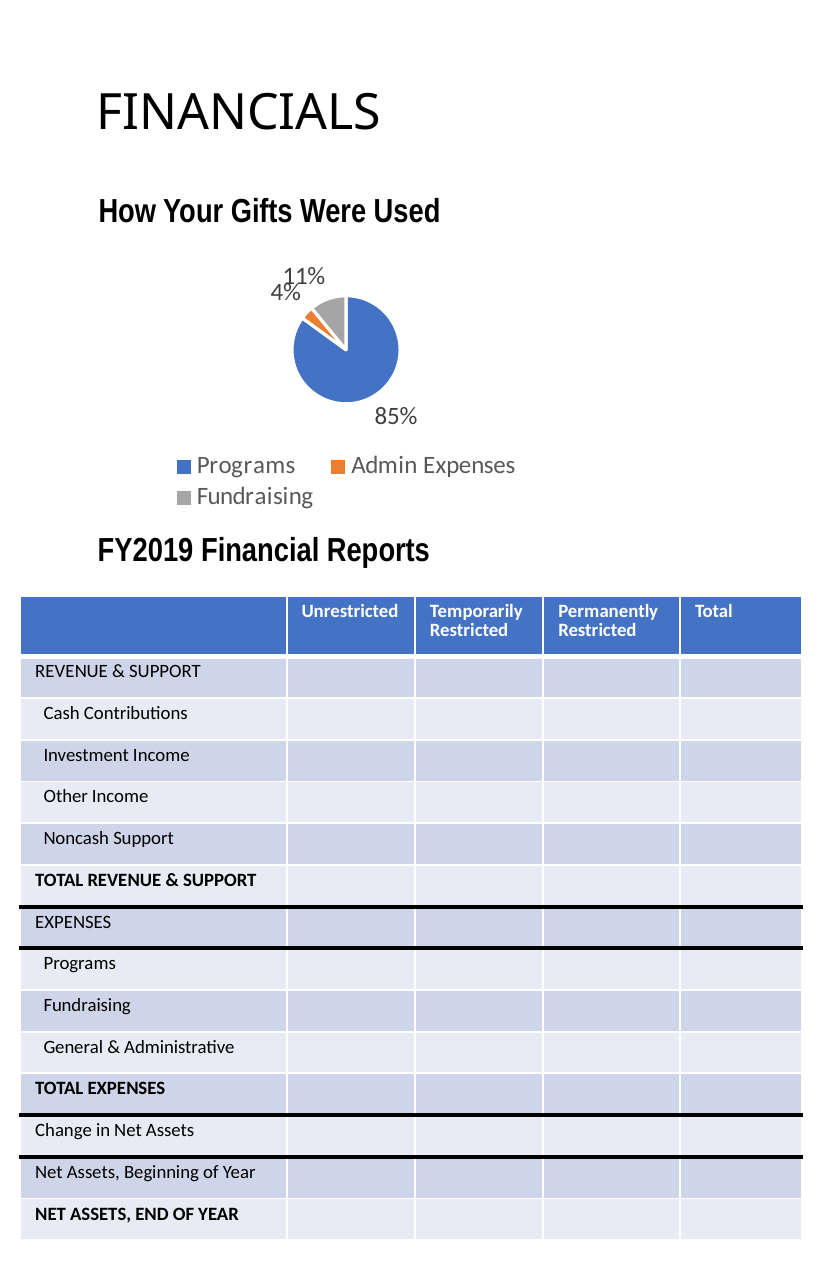
In the "How Your Gifts Were Used" pie chart, what share goes to Programs? 85% How many entries does the legend of the "How Your Gifts Were Used" pie chart list? 3 In the "How Your Gifts Were Used" pie chart, how many percentage points larger is Programs than Fundraising? 74 What kind of chart is shown under "How Your Gifts Were Used"? pie chart Which category has the largest slice in the "How Your Gifts Were Used" pie chart? Programs In the "How Your Gifts Were Used" pie chart, how many percentage points larger is Fundraising than Admin Expenses? 7 In the "How Your Gifts Were Used" pie chart, which is larger: Fundraising or Admin Expenses? Fundraising In the "How Your Gifts Were Used" pie chart, what share goes to Admin Expenses? 4% Which category has the smallest slice in the "How Your Gifts Were Used" pie chart? Admin Expenses How many slices does the "How Your Gifts Were Used" pie chart have? 3 What colour is the Programs slice in the "How Your Gifts Were Used" pie chart? blue In the "How Your Gifts Were Used" pie chart, what share goes to Fundraising? 11%